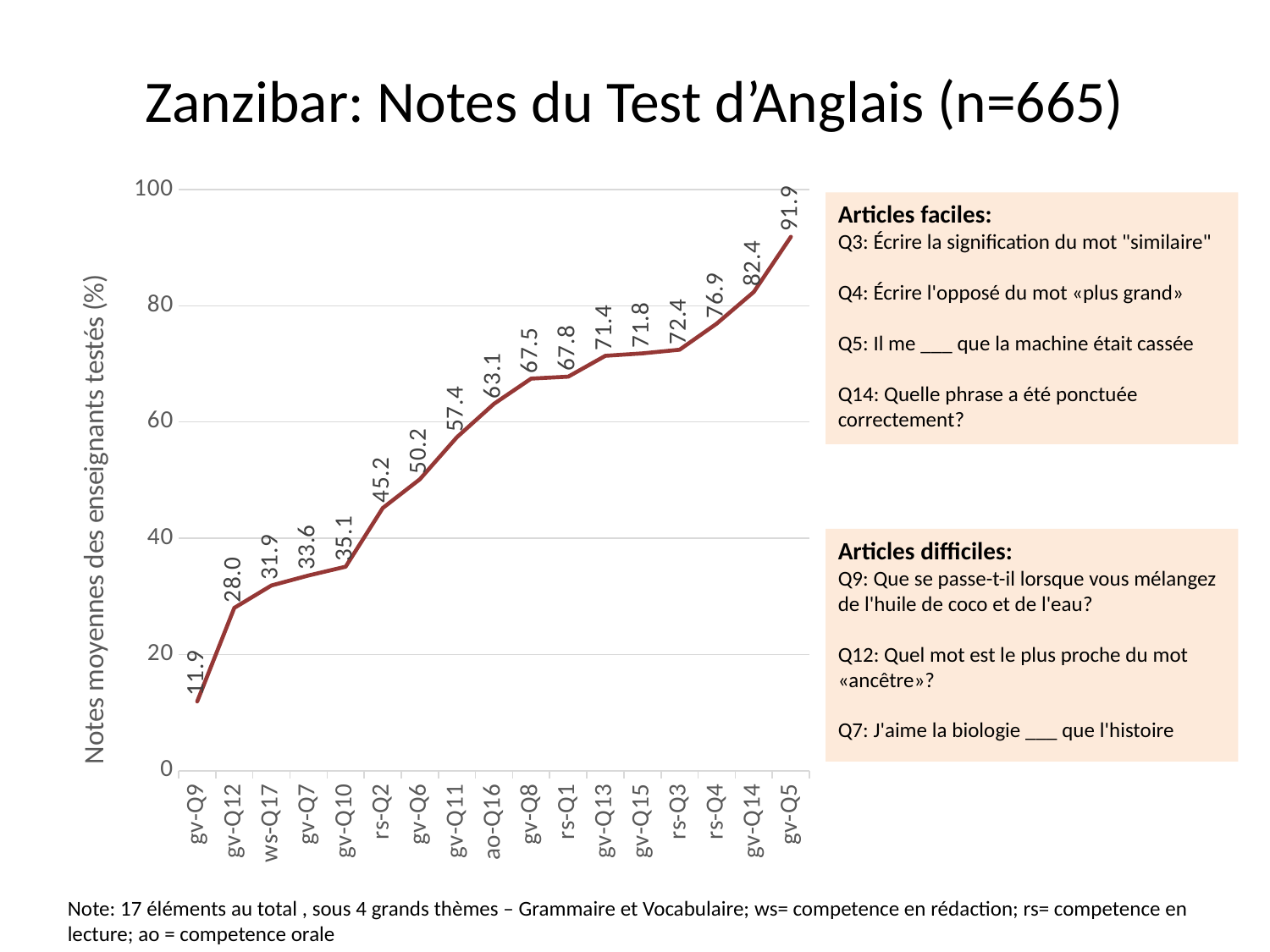
What is the value for ao-Q16? 63.1 Do the values rise or fall from left to right along the x axis? rise What is the value for gv-Q9? 11.9 Which category has the lowest value? gv-Q9 How many categories are plotted on the x axis? 17 What is the value for rs-Q2? 45.2 What is the value for gv-Q14? 82.4 What is the label of the vertical axis? Notes moyennes des enseignants testés (%) Which category has the highest value? gv-Q5 Which is larger, the value for gv-Q6 or the value for gv-Q11? gv-Q11 What is the difference between the values for gv-Q5 and gv-Q9? 80.0 What type of chart is shown on the slide? line chart